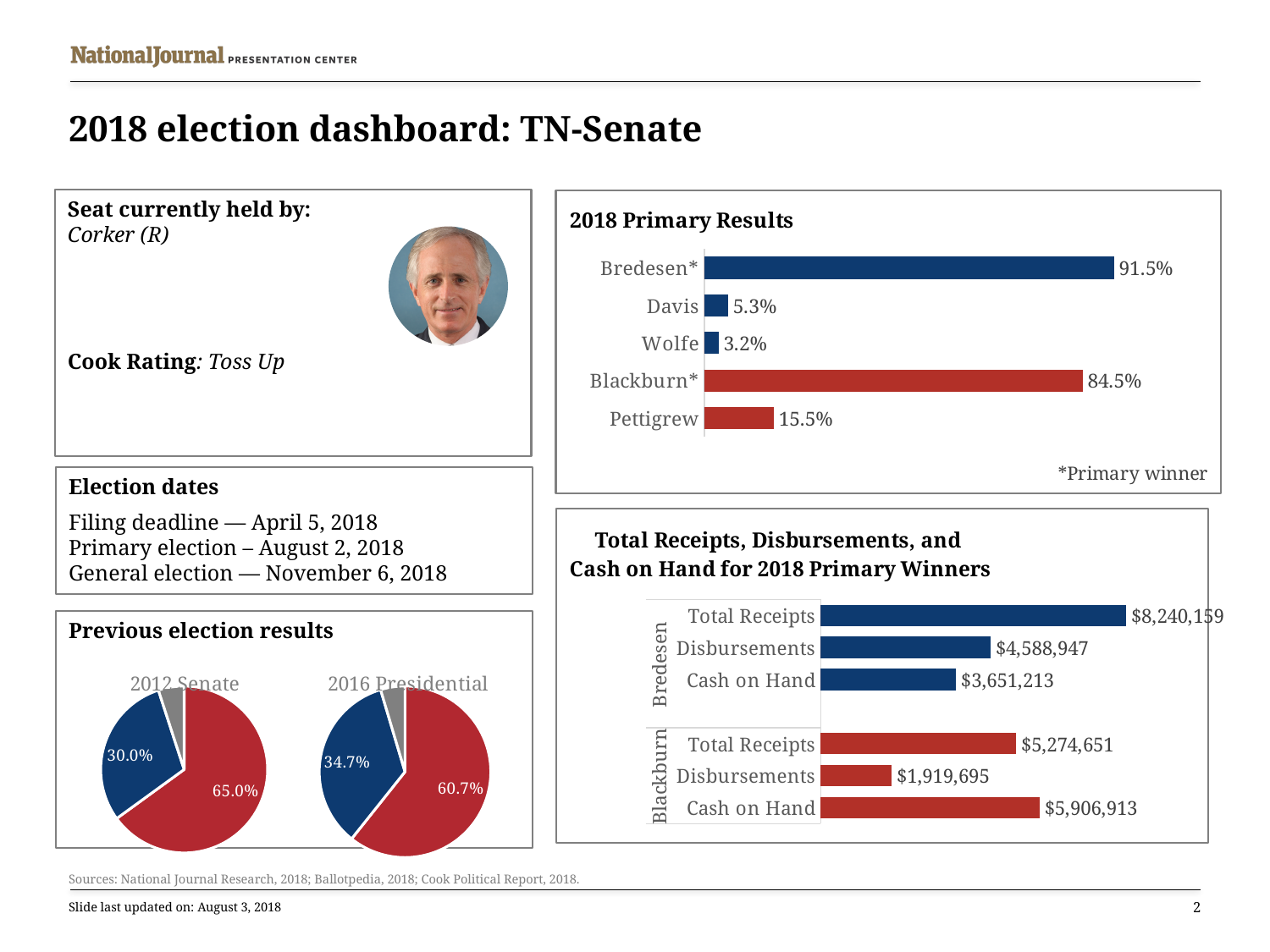
In the Total Receipts, Disbursements, and Cash on Hand chart, who has the larger Disbursements, Bredesen or Blackburn? Bredesen In the 2016 Presidential pie chart, what is the value of the blue slice? 34.7% In the 2018 Primary Results chart, what is the difference between Blackburn*'s and Pettigrew's percentages? 69.0% In the Total Receipts, Disbursements, and Cash on Hand chart, what is the difference between Bredesen's and Blackburn's Total Receipts? $2,965,508 In the Total Receipts, Disbursements, and Cash on Hand chart, what are Bredesen's Total Receipts? $8,240,159 In the 2012 Senate pie chart, what is the value of the largest slice? 65.0% In the 2018 Primary Results chart, which candidate has the lowest percentage? Wolfe In the 2018 Primary Results chart, what percentage did Pettigrew receive? 15.5% In the 2018 Primary Results chart, what percentage did Bredesen* receive? 91.5% In the Total Receipts, Disbursements, and Cash on Hand chart, what is Blackburn's Cash on Hand? $5,906,913 What kind of chart is the 2018 Primary Results chart? Bar chart In the 2018 Primary Results chart, how many candidates are shown? 5